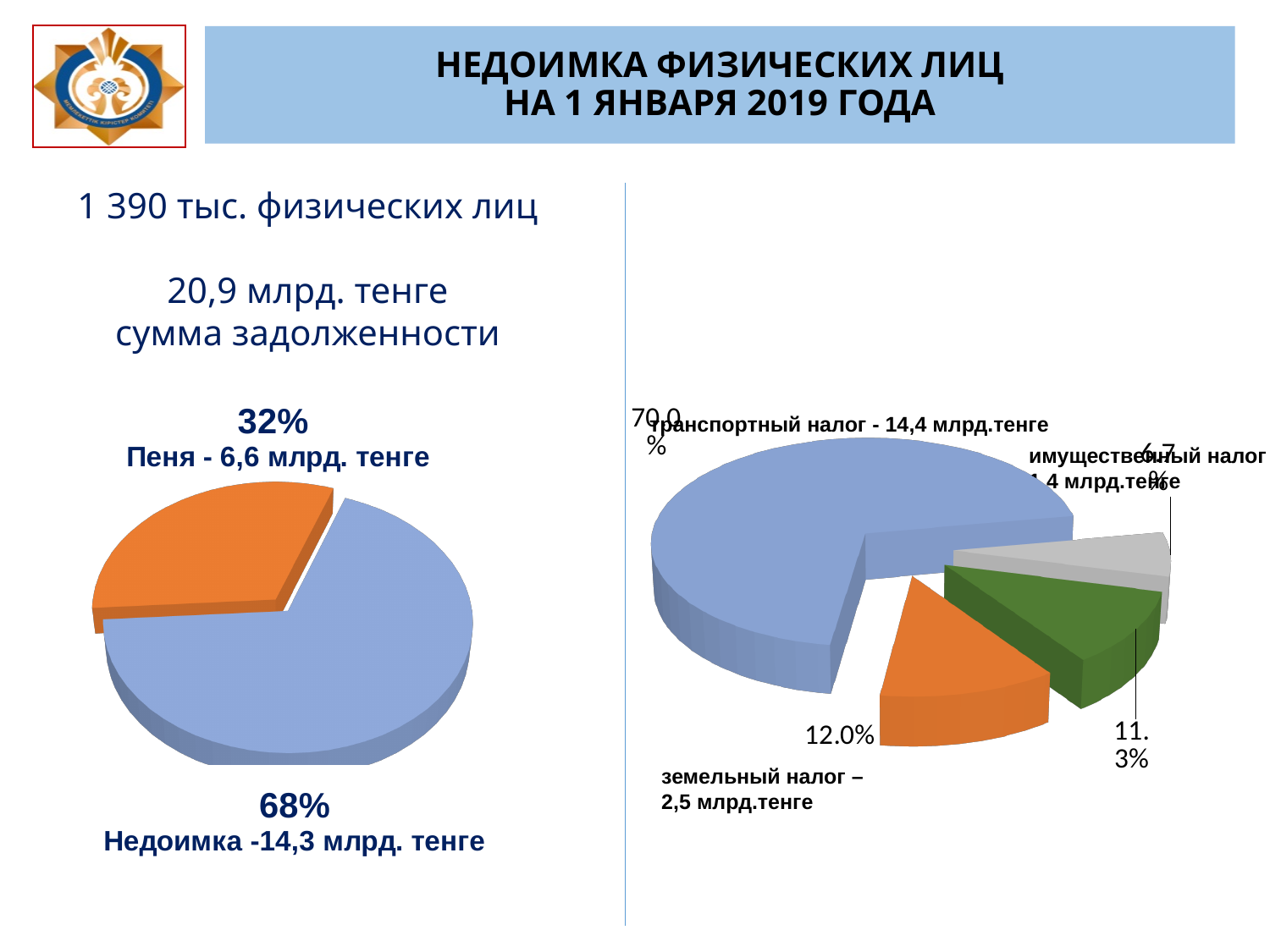
On the left pie chart, what is the difference in percentage points between the Недоимка and Пеня shares? 36 On the left pie chart, which slice is larger, Пеня or Недоимка? Недоимка On the right pie chart, what percentage is shown for транспортный налог? 70.0% On the right pie chart, what percentage is shown for земельный налог? 12.0% On the right pie chart, what percentage is shown for имущественный налог? 6.7% On the right pie chart, which category has the largest slice? транспортный налог On the right pie chart, what amount in млрд.тенге is given for транспортный налог? 14,4 млрд.тенге On the left pie chart, what amount in млрд. тенге is given for Недоимка? 14,3 млрд. тенге On the left pie chart, what amount in млрд. тенге is given for Пеня? 6,6 млрд. тенге On the left pie chart, what share is labelled for Пеня? 32% What type of chart is used on the right side of the slide? pie chart On the left pie chart, what share is labelled for Недоимка? 68%